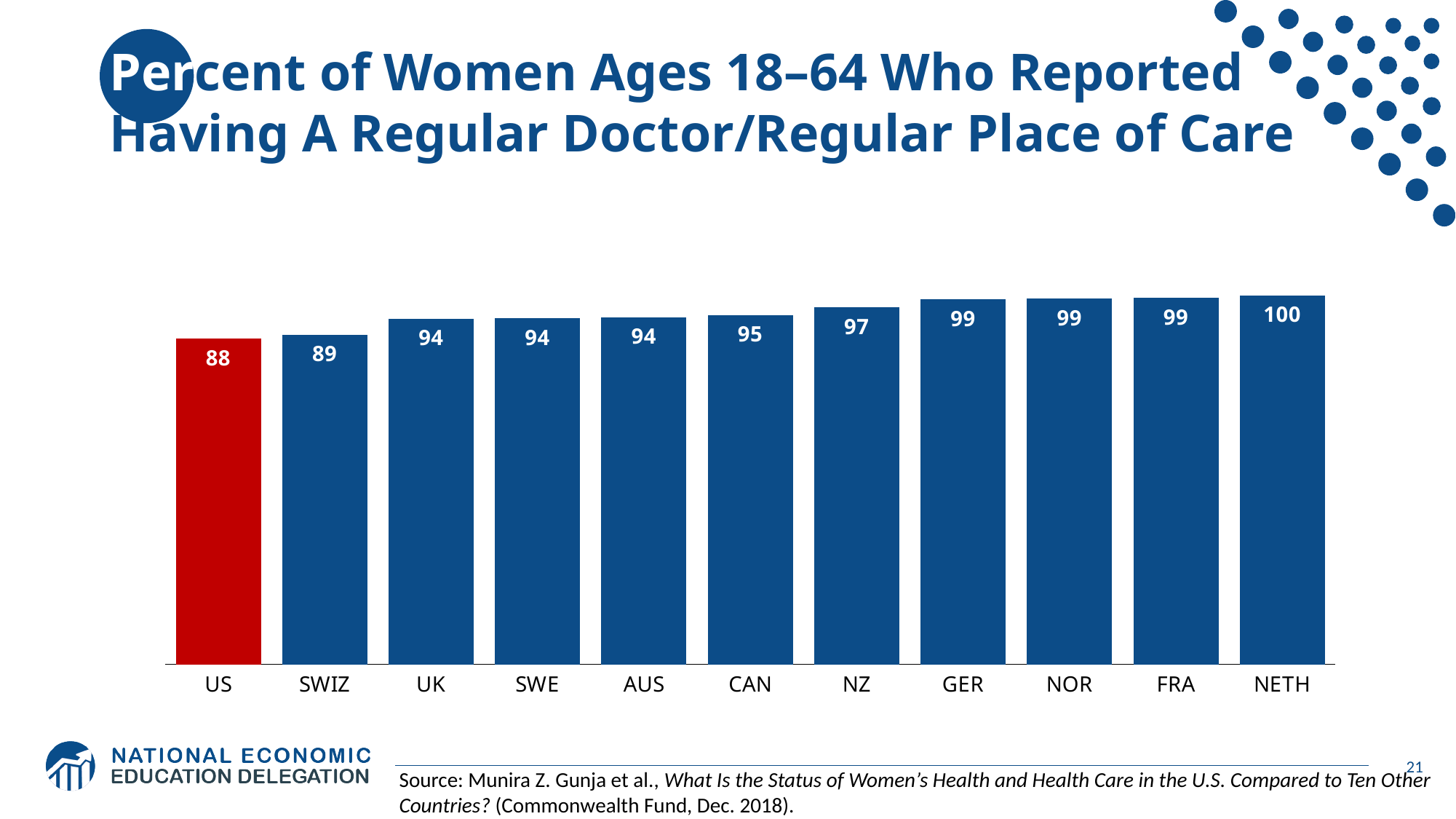
What kind of chart is shown on the slide? bar chart Do the values rise or fall from left to right across the countries? rise Which is larger, the value for UK or the value for NZ? NZ What is the value for NZ? 97 What is the difference between the values for NETH and the US? 12 What is the value for CAN? 95 Which country has the lowest value? US What is the difference between the values for SWIZ and the US? 1 What is the value for the US? 88 Which bar is coloured red rather than blue? US Which country has the highest value? NETH How many countries are shown in the chart? 11